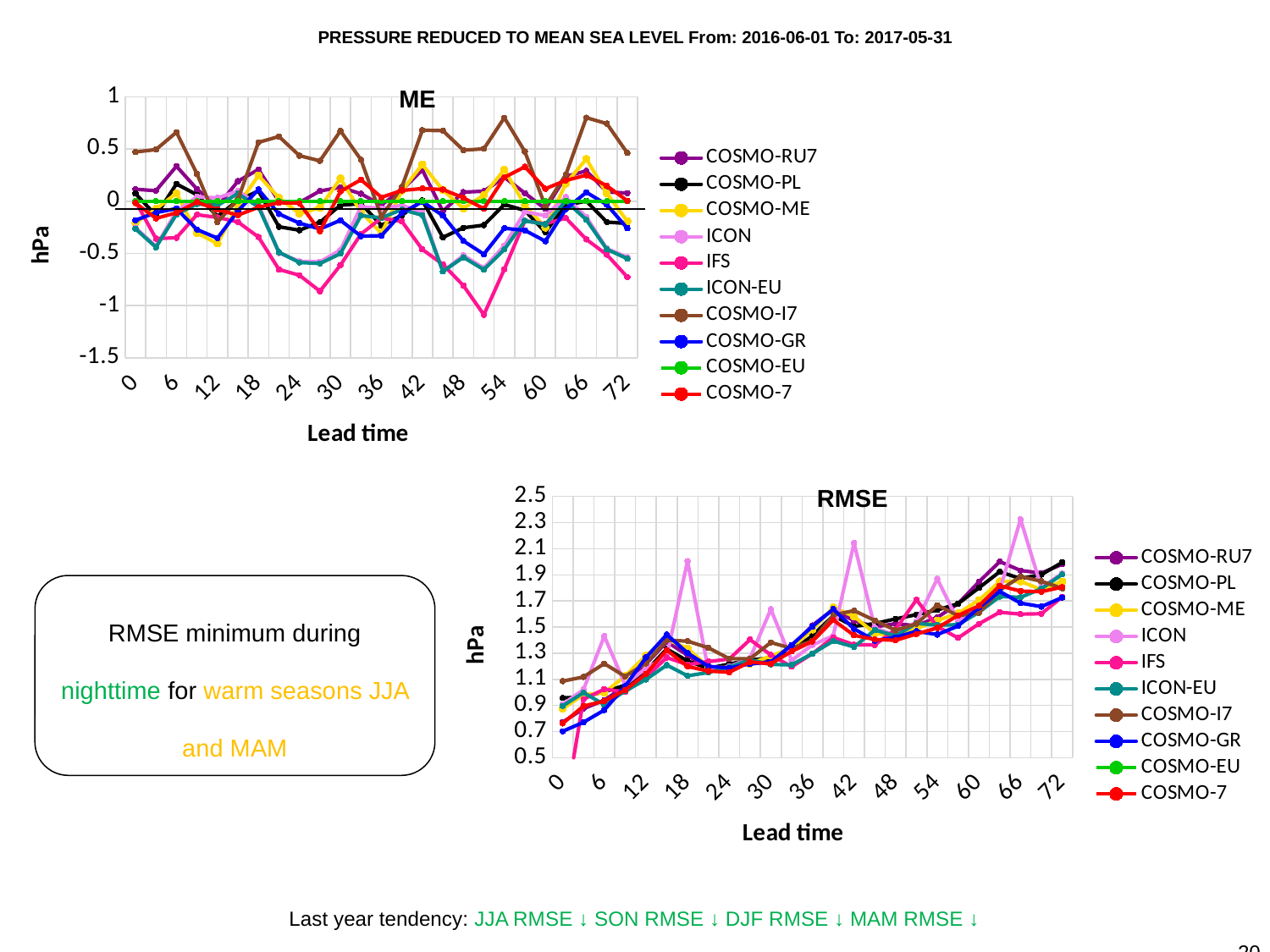
In the RMSE chart, which series reaches the highest peak? ICON In the RMSE chart, do the values generally rise or fall as lead time increases? rise In the RMSE chart, is the value for ICON at lead time 66 greater or less than 2.1? greater How many lead time tick labels are shown on the x axis of the RMSE chart? 13 What is the x-axis label on the RMSE chart? Lead time What is the y-axis label on the ME chart? hPa In the ME chart, which series has the lowest value at lead time 54? IFS In the ME chart, is the value for COSMO-I7 at lead time 66 greater or less than 0.5? greater In the RMSE chart, which is larger at lead time 66, ICON or IFS? ICON In the ME chart, is the value for IFS at lead time 54 greater or less than -0.5? less How many series does the legend of the RMSE chart list? 10 What kind of chart is the ME chart? line chart